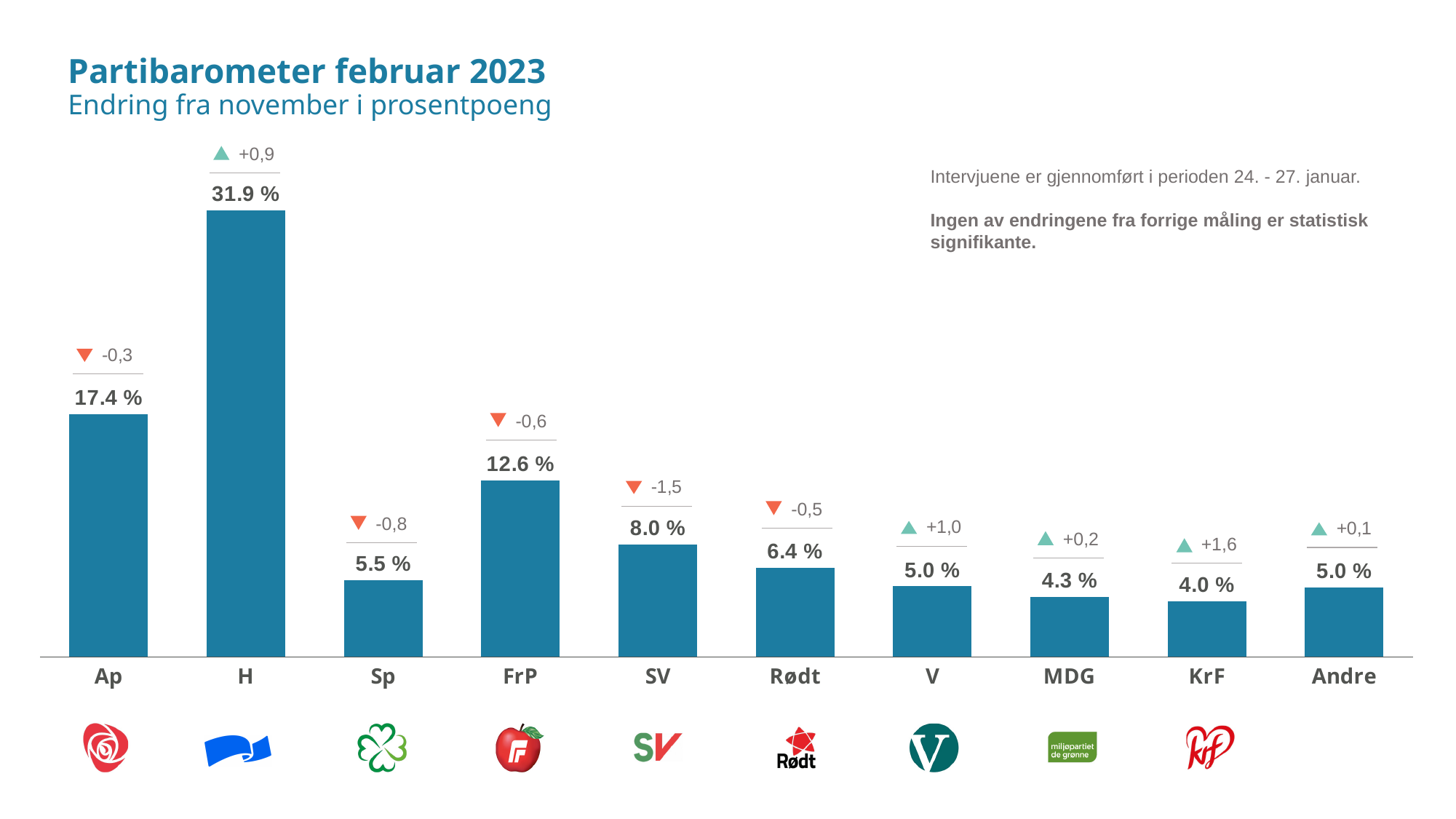
What change from November is shown above the SV bar? -1,5 What is the value shown for Ap? 17.4 % What change from November is shown above the KrF bar? +1,6 Which has the larger value, Sp or Rødt? Rødt Which party has the lowest value? KrF What kind of chart is shown on the slide? Bar chart How many categories are shown on the x axis? 10 What is the difference between the values for H and Ap? 14.5 % Which party has the highest value? H What is the value shown for H? 31.9 % What is the value shown for FrP? 12.6 % What is the value shown for MDG? 4.3 %